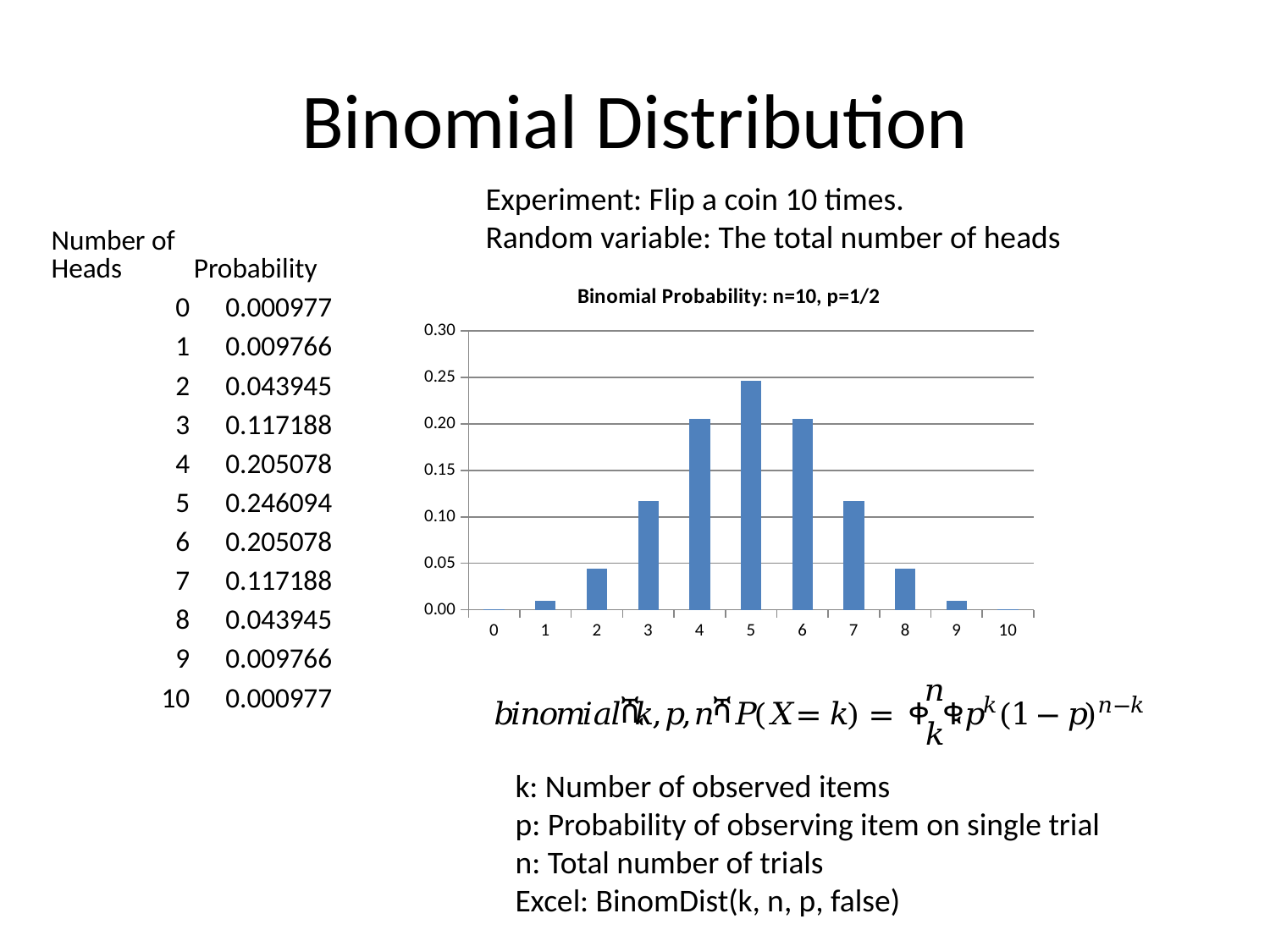
What is the title of the chart? Binomial Probability: n=10, p=1/2 Is the value for 5 heads greater or less than 0.20? greater Do the bar values rise or fall as the number of heads goes from 0 to 5? rise According to the table on the slide, what is the probability of getting 3 heads? 0.117188 Which number of heads has the highest probability in the chart? 5 Which is larger, the probability for 3 heads or the probability for 4 heads? 4 heads Using the values in the table, what is the difference between the probability of 5 heads and the probability of 4 heads? 0.041016 According to the table on the slide, what is the probability of getting 5 heads? 0.246094 Is the value for 4 heads greater or less than 0.15? greater How many bars (categories) are plotted along the x axis of the chart? 11 Is the value for 2 heads greater or less than 0.05? less What kind of chart is shown on the slide? bar chart